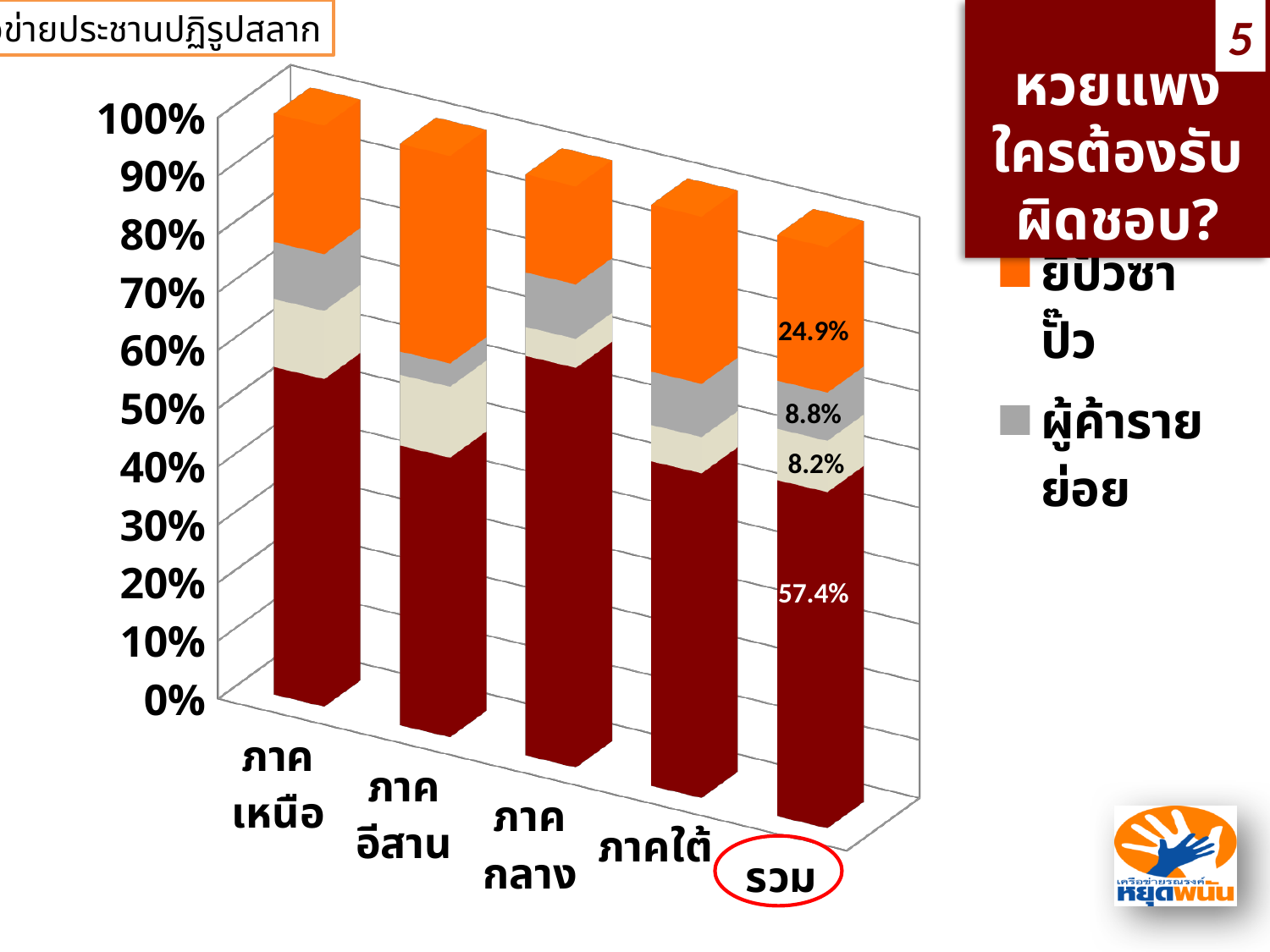
Which colour represents ยี่ปั๊วซาปั๊ว in the legend? Orange In the รวม bar, which is larger: ยี่ปั๊วซาปั๊ว or ผู้ค้ารายย่อย? ยี่ปั๊วซาปั๊ว What percentage is shown for ผู้ค้ารายย่อย (gray segment) in the รวม bar? 8.8% What kind of chart is shown on the slide? Stacked bar chart Which category label on the x axis is circled in red? รวม What is the smallest labelled value on the รวม bar? 8.2% What value is labelled on the bottom dark red segment of the รวม bar? 57.4% How many categories are shown along the x axis of the chart? 5 What value is labelled on the cream-coloured segment of the รวม bar? 8.2% Is the dark red segment for ภาคเหนือ greater or less than 30%? greater What percentage is shown for ยี่ปั๊วซาปั๊ว (orange segment) in the รวม bar? 24.9% In the รวม bar, how much larger is the ยี่ปั๊วซาปั๊ว value than the ผู้ค้ารายย่อย value? 16.1 percentage points